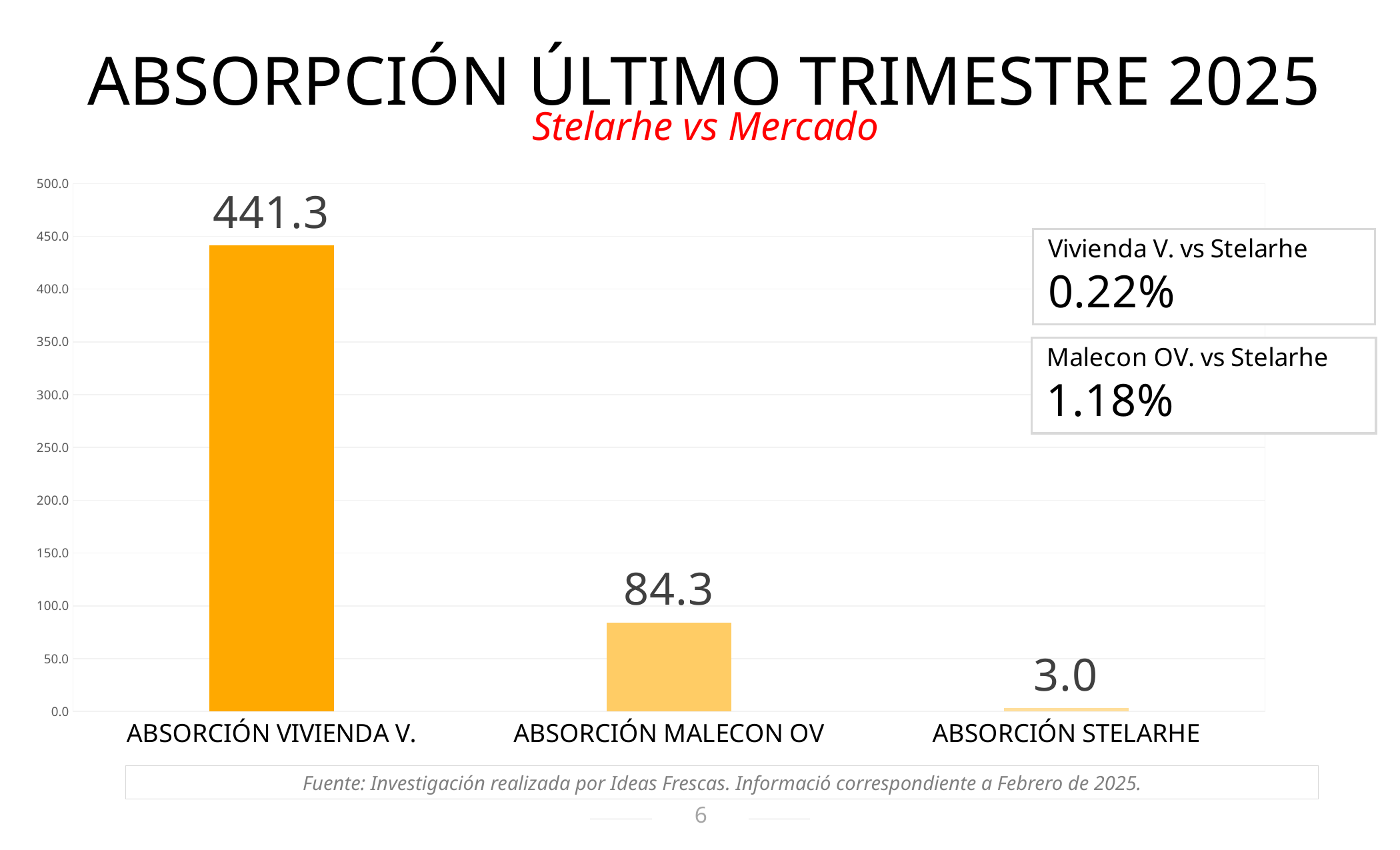
Is the value for ABSORCIÓN VIVIENDA V. greater or less than 400.0? greater Which category has the highest value? ABSORCIÓN VIVIENDA V. What is the value for ABSORCIÓN STELARHE? 3.0 What is the difference between the values for ABSORCIÓN VIVIENDA V. and ABSORCIÓN MALECON OV? 357.0 Which is larger, the value for ABSORCIÓN MALECON OV or ABSORCIÓN STELARHE? ABSORCIÓN MALECON OV Which category has the lowest value? ABSORCIÓN STELARHE What is the value for ABSORCIÓN MALECON OV? 84.3 What kind of chart is shown on the slide? bar chart What is the value for ABSORCIÓN VIVIENDA V.? 441.3 How many categories are shown in the chart? 3 What is the difference between the values for ABSORCIÓN MALECON OV and ABSORCIÓN STELARHE? 81.3 What is the red subtitle shown under the slide title? Stelarhe vs Mercado